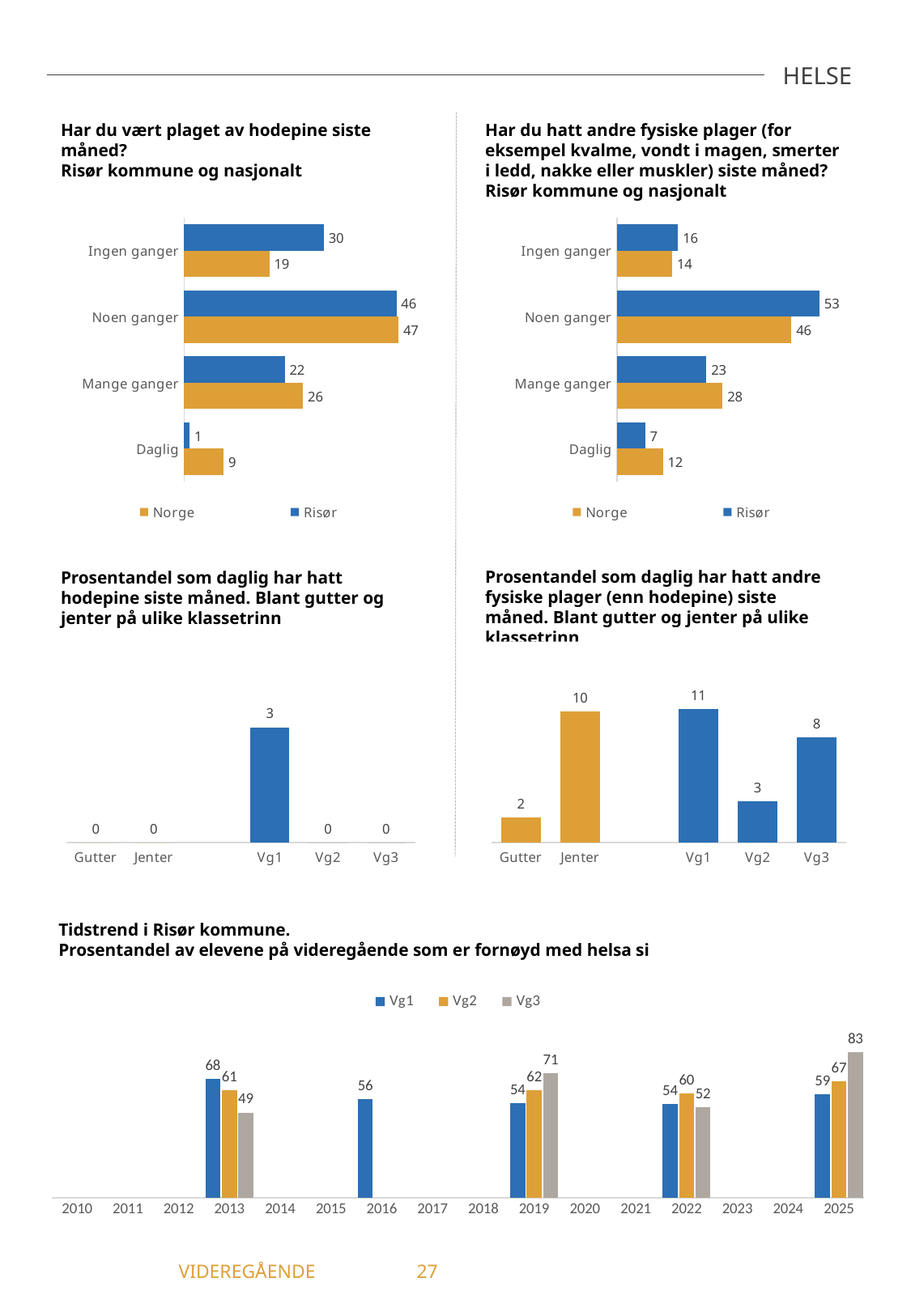
In the chart 'Har du vært plaget av hodepine siste måned?', what is the value for Risør in the 'Ingen ganger' category? 30 How many series does the legend list in the chart 'Har du vært plaget av hodepine siste måned?'? 2 In the chart 'Prosentandel som daglig har hatt andre fysiske plager (enn hodepine) siste måned', what is the value for Jenter? 10 In the chart 'Tidstrend i Risør kommune', what is the difference between the Vg1 values in 2013 and 2016? 12 What kind of chart is 'Tidstrend i Risør kommune'? Bar chart In the chart 'Har du hatt andre fysiske plager ... siste måned?', which is larger for 'Daglig': Norge or Risør? Norge In the chart 'Prosentandel som daglig har hatt hodepine siste måned', which category has the highest value? Vg1 In the chart 'Tidstrend i Risør kommune', what is the value for Vg3 in 2025? 83 In the chart 'Har du hatt andre fysiske plager ... siste måned?', what is the value for Norge in the 'Mange ganger' category? 28 In the chart 'Har du hatt andre fysiske plager ... siste måned?', which category has the highest value for Risør? Noen ganger In the chart 'Prosentandel som daglig har hatt andre fysiske plager (enn hodepine) siste måned', which category has the lowest value? Gutter In the chart 'Har du vært plaget av hodepine siste måned?', what is the difference between the Norge and Risør values for 'Daglig'? 8